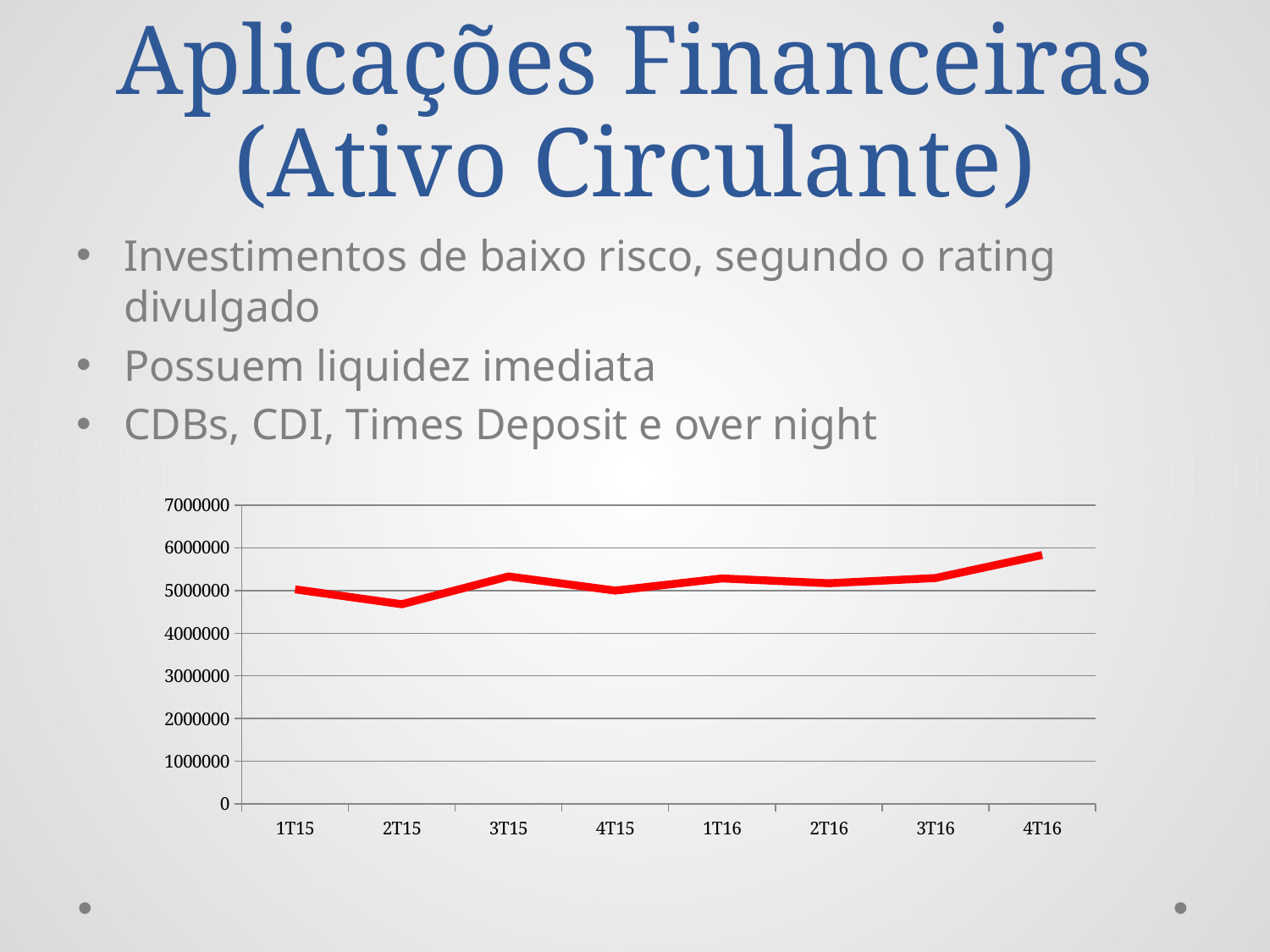
Is the value for 4T16 greater or less than 5000000? greater Which is larger, the value for 3T15 or the value for 2T15? 3T15 Is the value for 2T15 greater or less than 4000000? greater What kind of chart is shown on the slide? line chart How many quarters are plotted along the x axis of the chart? 8 Which quarter has the highest value in the chart? 4T16 Overall, does the line rise or fall from 1T15 to 4T16? rise Which is larger, the value for 4T16 or the value for 2T15? 4T16 What colour is the line in the chart? red Is the value for 4T16 greater or less than 6000000? less Which quarter has the lowest value in the chart? 2T15